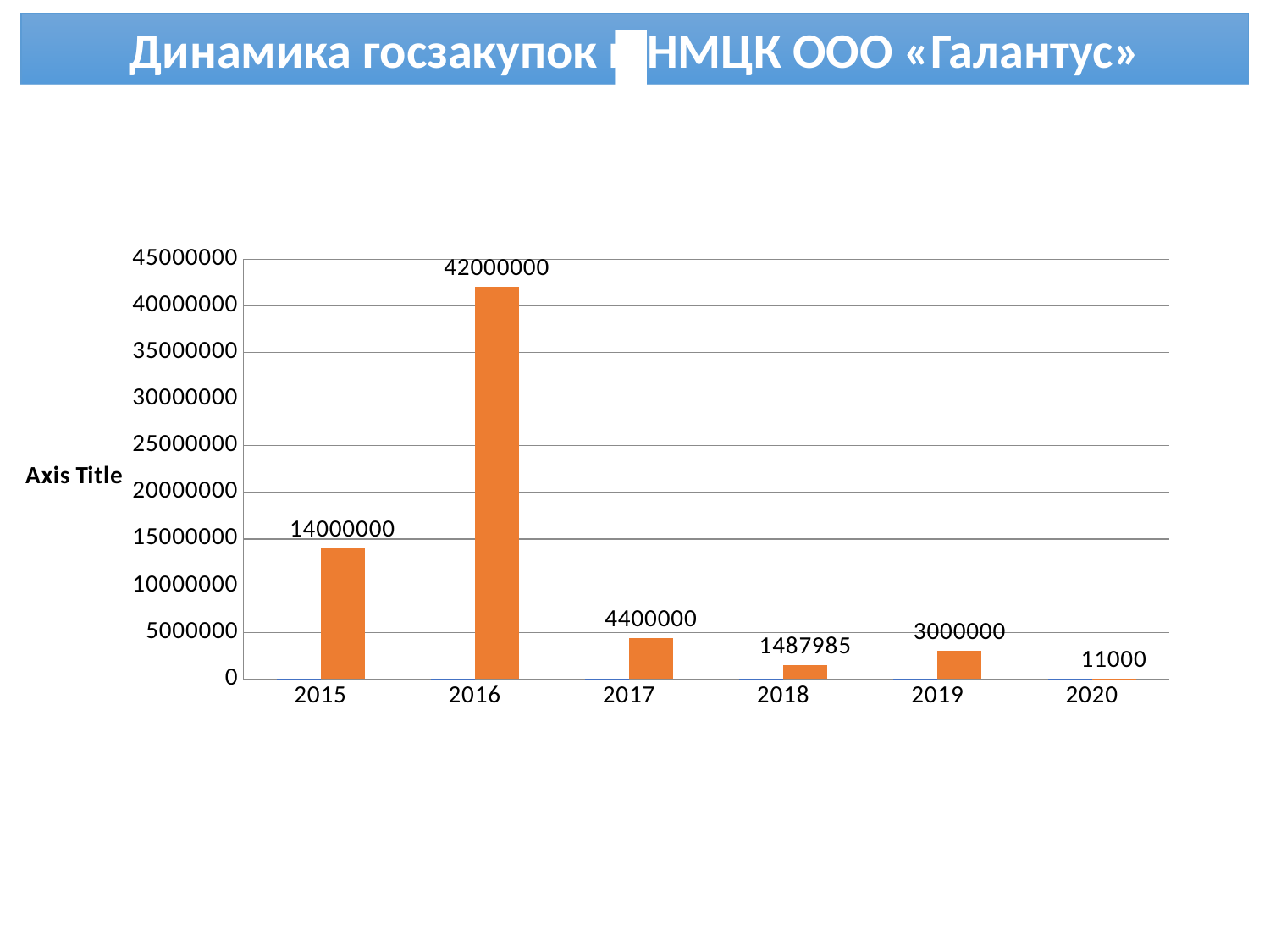
Is the value for 2015 greater or less than 10000000? greater What is the difference between the values for 2016 and 2015? 28000000 Between 2016 and 2018, do the values rise or fall? fall What is the value for 2016? 42000000 What kind of chart is shown on the slide? bar chart What is the difference between the values for 2017 and 2019? 1400000 Which is larger, the value for 2018 or the value for 2019? 2019 Which year has the lowest labelled value? 2020 How many years are shown on the x axis? 6 What is the value for 2020? 11000 Which year has the highest value? 2016 What is the value for 2018? 1487985